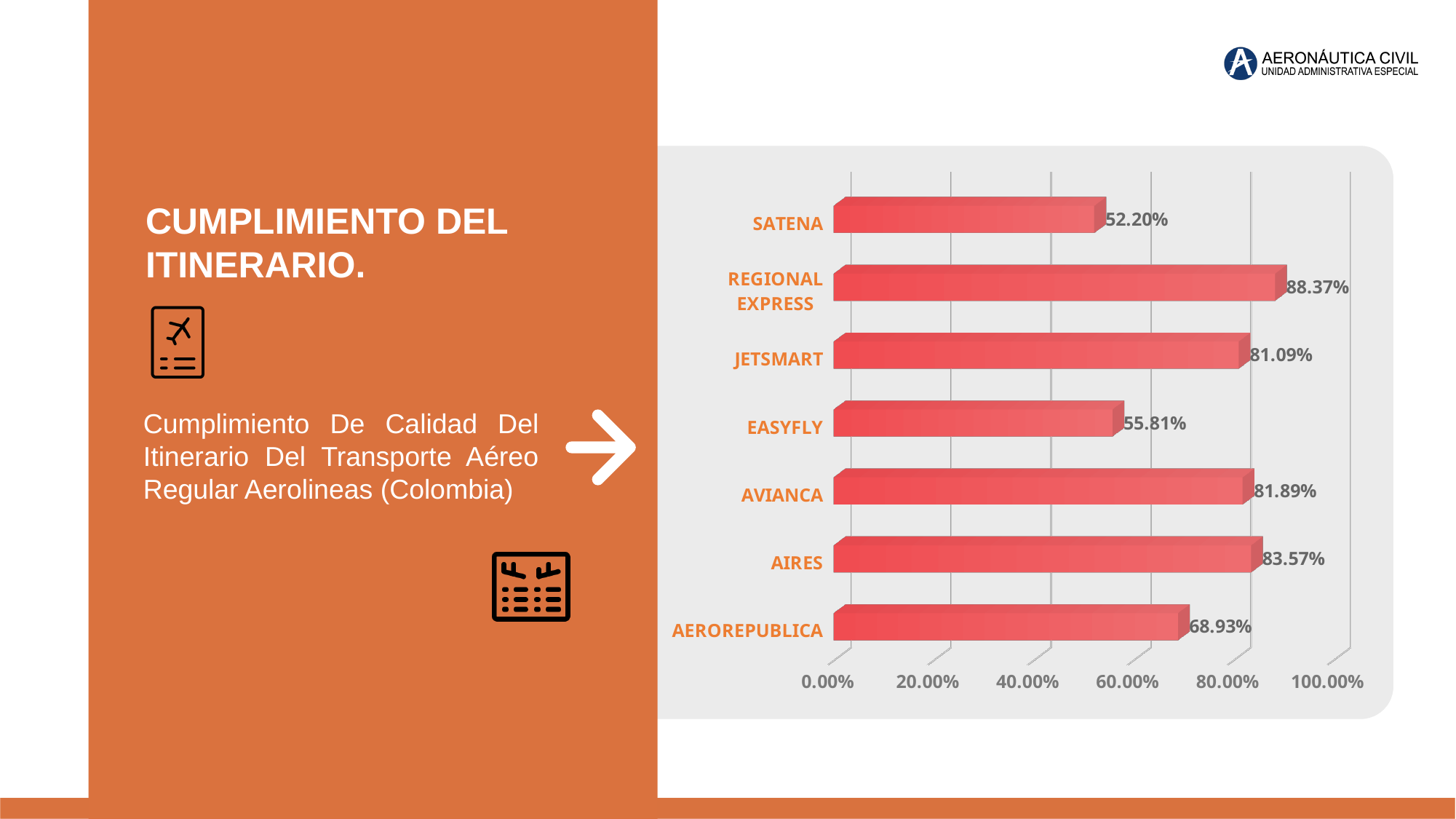
What is the value for SATENA? 52.20% Which airline has the highest value? REGIONAL EXPRESS What is the value for AEROREPUBLICA? 68.93% Which airline has the lowest value? SATENA Which is larger, the value for JETSMART or the value for EASYFLY? JETSMART What is the value for REGIONAL EXPRESS? 88.37% What is the difference between the values for REGIONAL EXPRESS and SATENA? 36.17% What is the maximum value shown on the horizontal axis? 100.00% Is the value for AEROREPUBLICA greater or less than 60.00%? greater How many airlines are shown in the chart? 7 What kind of chart is shown on the slide? bar chart What is the difference between the values for AIRES and AVIANCA? 1.68%